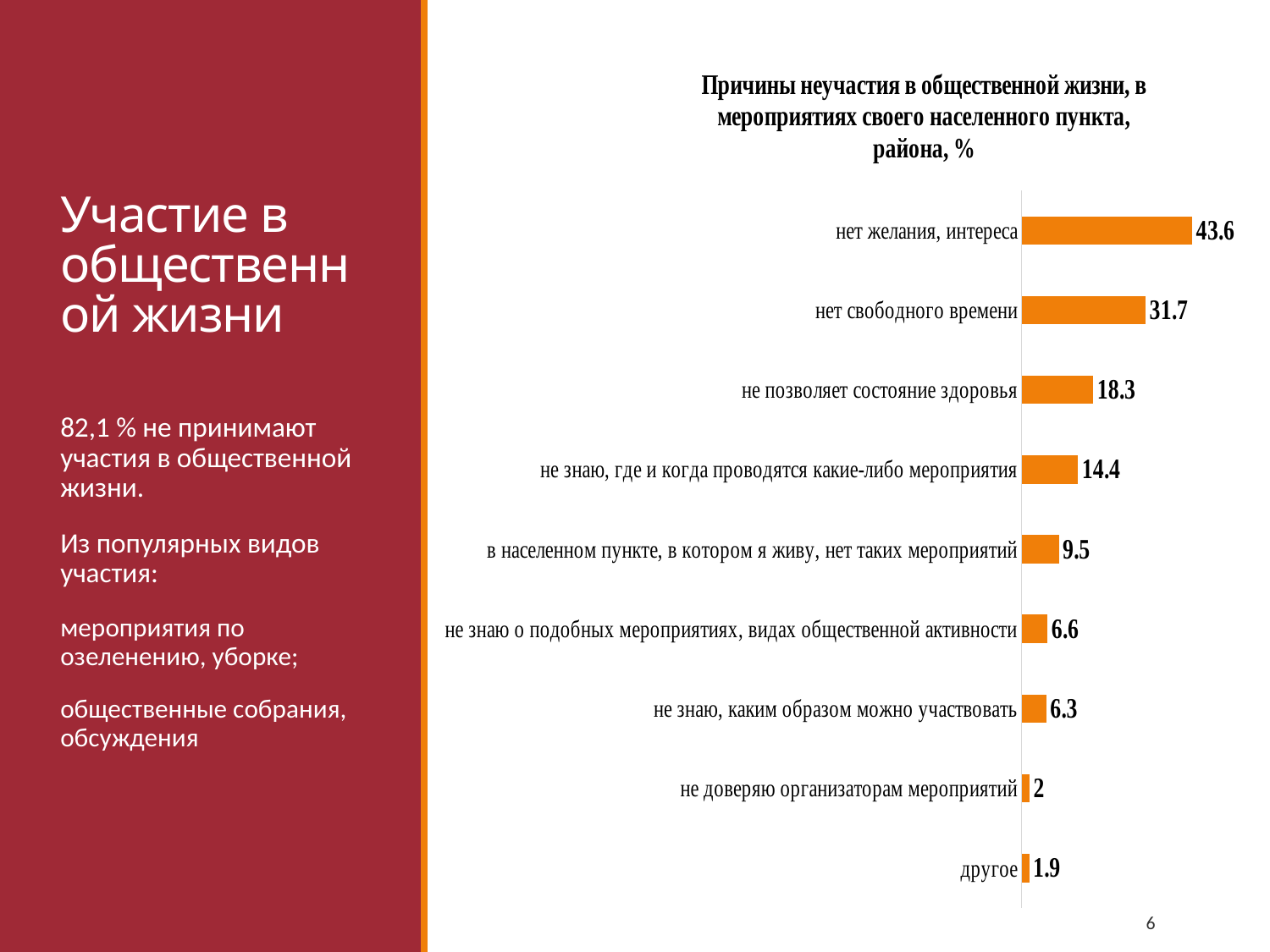
What is the difference between the values for "нет желания, интереса" and "нет свободного времени"? 11.9 Which category has the highest value? нет желания, интереса What is the value for "не позволяет состояние здоровья"? 18.3 Which category has the lowest value? другое Which is larger: the value for "не знаю, где и когда проводятся какие-либо мероприятия" or the value for "в населенном пункте, в котором я живу, нет таких мероприятий"? не знаю, где и когда проводятся какие-либо мероприятия What colour are the bars in the chart? orange What is the value for "не доверяю организаторам мероприятий"? 2 What is the difference between the values for "не знаю о подобных мероприятиях, видах общественной активности" and "не знаю, каким образом можно участвовать"? 0.3 What is the title of the chart? Причины неучастия в общественной жизни, в мероприятиях своего населенного пункта, района, % What kind of chart is shown on the slide? bar chart What is the value for "нет желания, интереса"? 43.6 How many categories are shown in the chart? 9